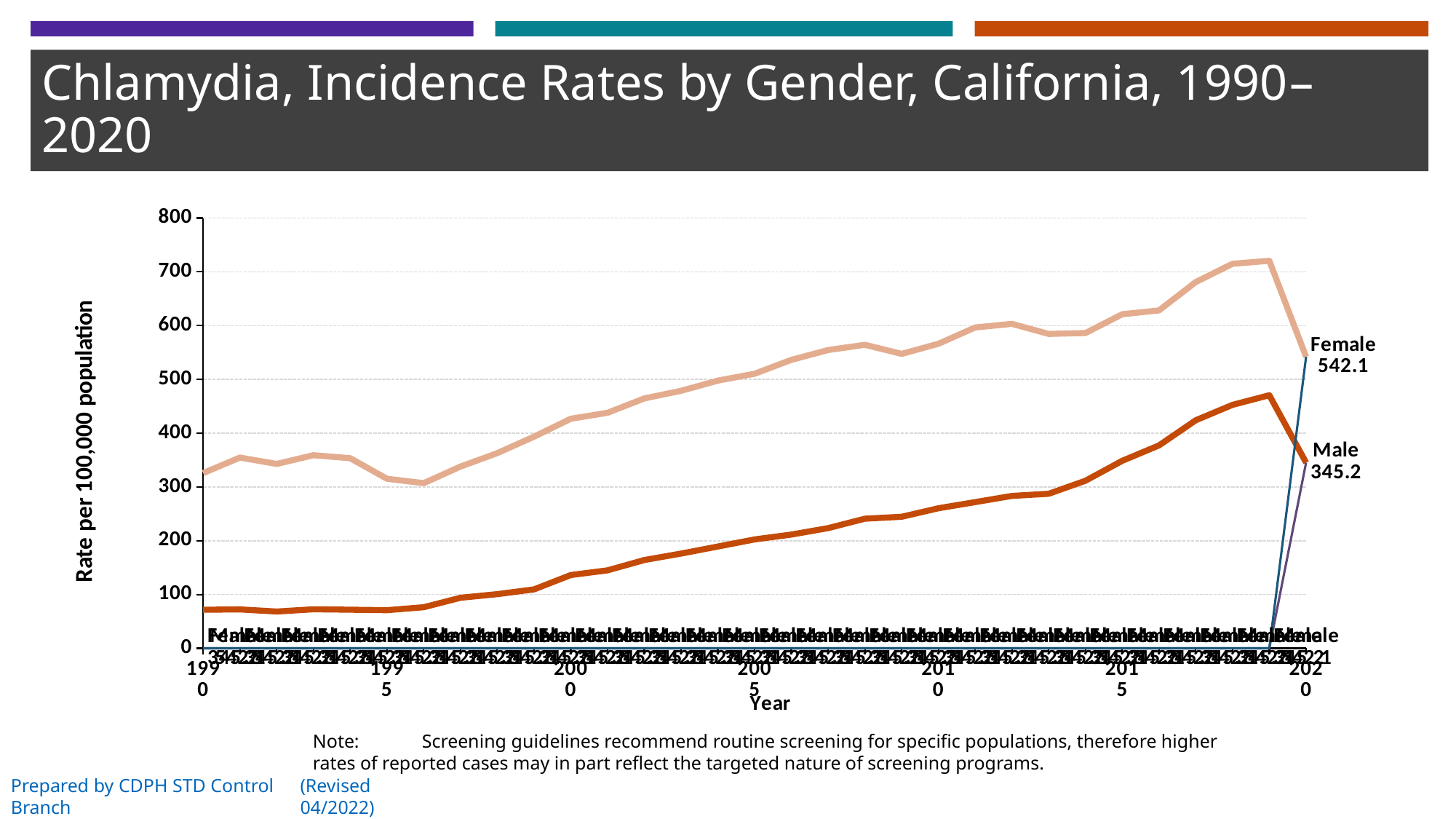
Does the Male rate generally rise or fall from 1990 to 2019? rise What is the Male chlamydia incidence rate in 2020? 345.2 What is the difference between the Female and Male rates in 2020? 196.9 Which series has the higher rate across the whole period shown? Female Is the peak of the Female line (around 2019) greater or less than 700? greater Which gender has the higher incidence rate in 2020? Female Is the Female rate in 1990 greater or less than 300? greater Is the Male rate in 1990 greater or less than 100? less What type of chart is shown on the slide? line chart What is the Female chlamydia incidence rate in 2020? 542.1 What is the label of the vertical axis? Rate per 100,000 population